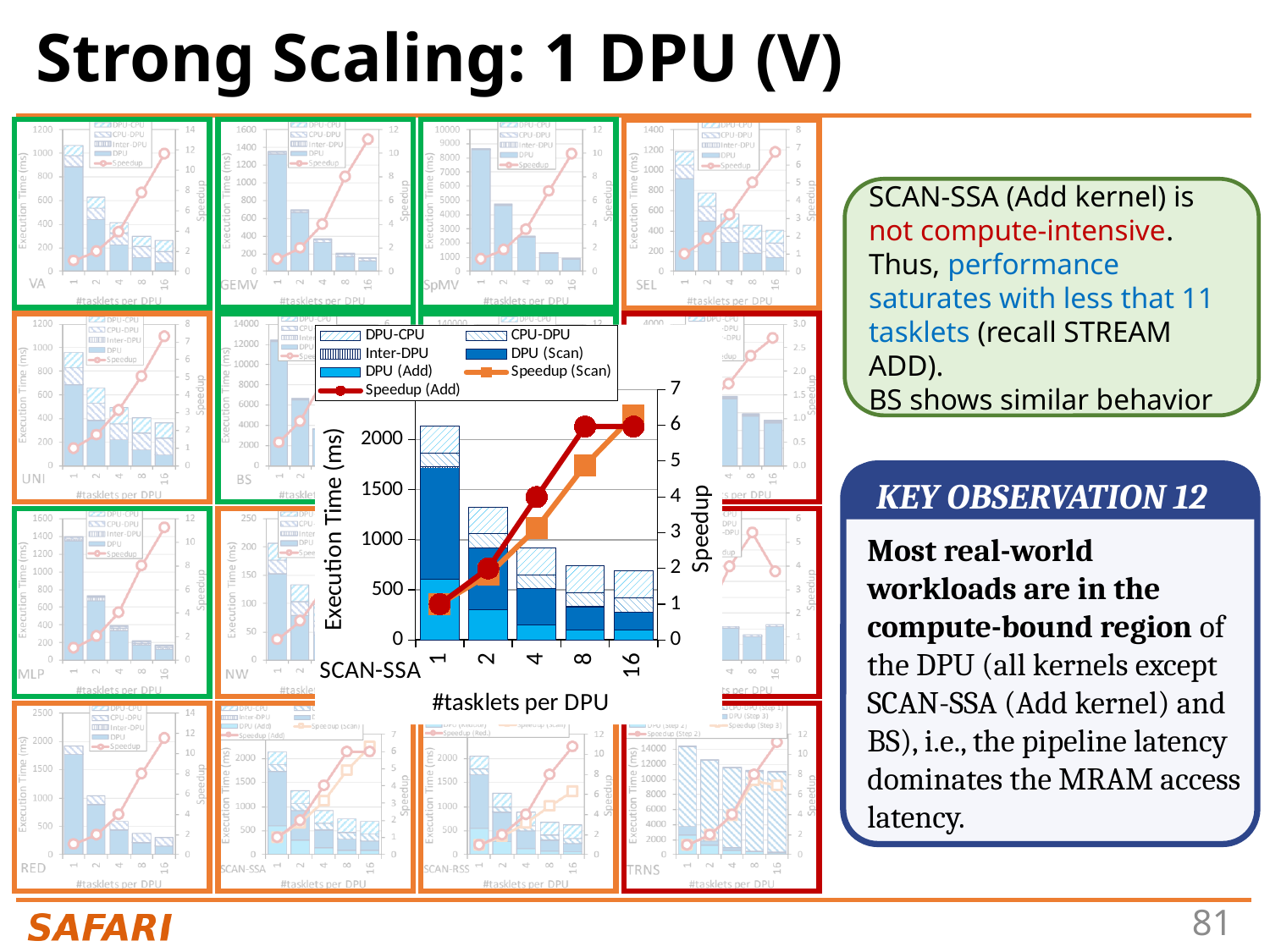
In the enlarged SCAN-SSA chart, does the Speedup (Add) line rise or fall as #tasklets per DPU increases? Rises In the enlarged SCAN-SSA chart, is the Speedup (Scan) value for 2 tasklets per DPU greater or less than 3? less What kind of chart is the enlarged SCAN-SSA chart? A stacked bar chart combined with line series In the enlarged SCAN-SSA chart, is the total execution time for 16 tasklets per DPU greater or less than 1000? less In the enlarged SCAN-SSA chart, is the total execution time for 1 tasklet per DPU greater or less than 2000? greater In the enlarged SCAN-SSA chart, which has the larger total execution time: 1 tasklet per DPU or 16 tasklets per DPU? 1 tasklet per DPU What is the label of the left vertical axis in the enlarged SCAN-SSA chart? Execution Time (ms) In the enlarged SCAN-SSA chart, how many series does the legend list? 7 In the enlarged SCAN-SSA chart, how many #tasklets per DPU categories are shown on the x axis? 5 In the enlarged SCAN-SSA chart, which #tasklets per DPU value has the highest total execution time? 1 In the enlarged SCAN-SSA chart, does the total execution time rise or fall as #tasklets per DPU increases? Falls